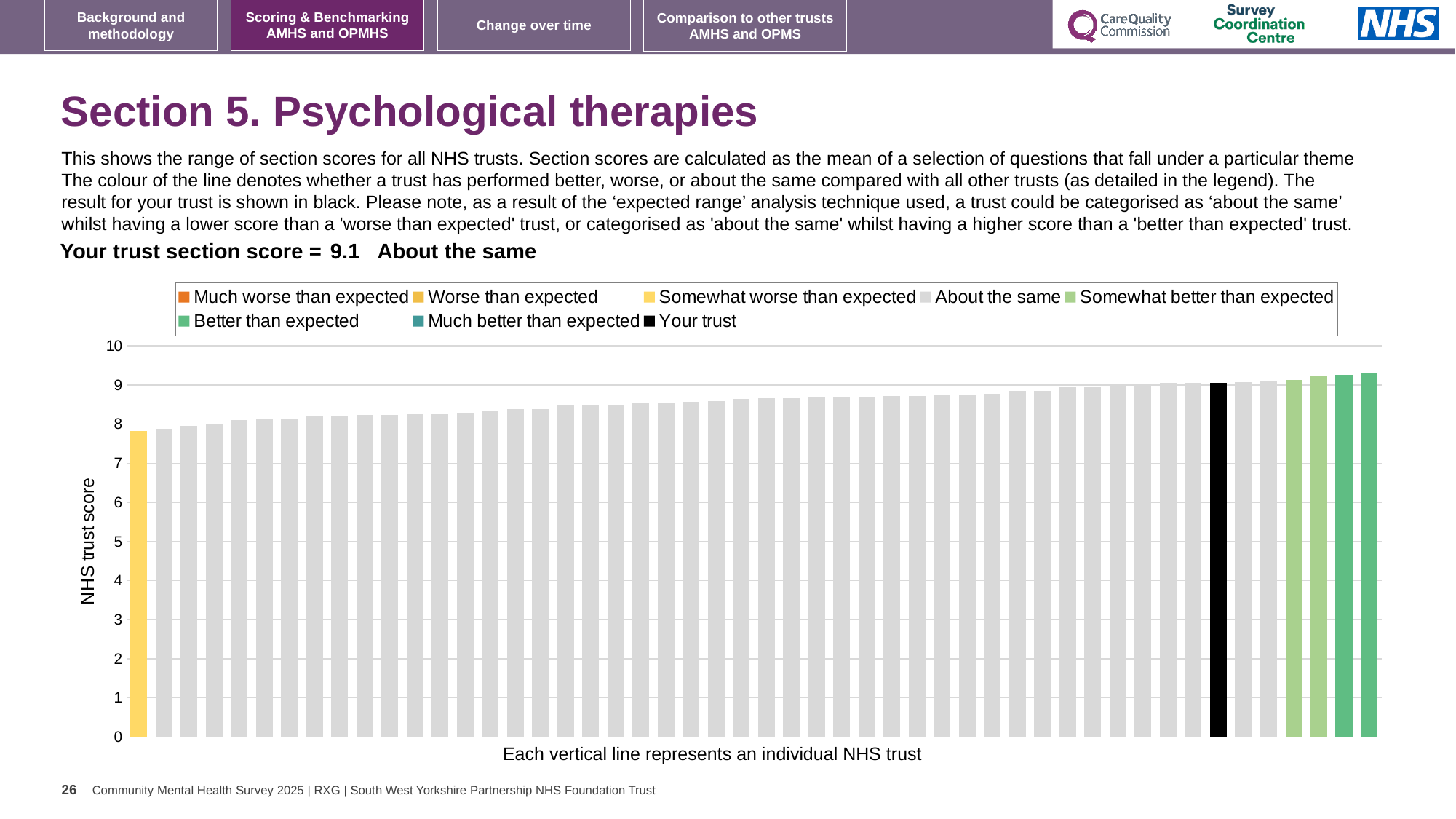
Do the bar values rise or fall from left to right along the x axis? rise What is the label on the vertical axis of the chart? NHS trust score Is the value of the rightmost bar greater or less than 9? greater What is the section score for your trust shown on the slide? 9.1 What colour is the bar representing your trust? Black How many bars are coloured green (better than expected categories)? 4 How many bars are coloured yellow (worse than expected categories)? 1 What kind of chart is shown on the slide? Bar chart How many entries does the chart legend list? 8 Is the value of the leftmost (yellow) bar greater or less than 7? greater Is the value of the black bar (your trust) greater or less than 8? greater Which category is your trust placed in for this section? About the same